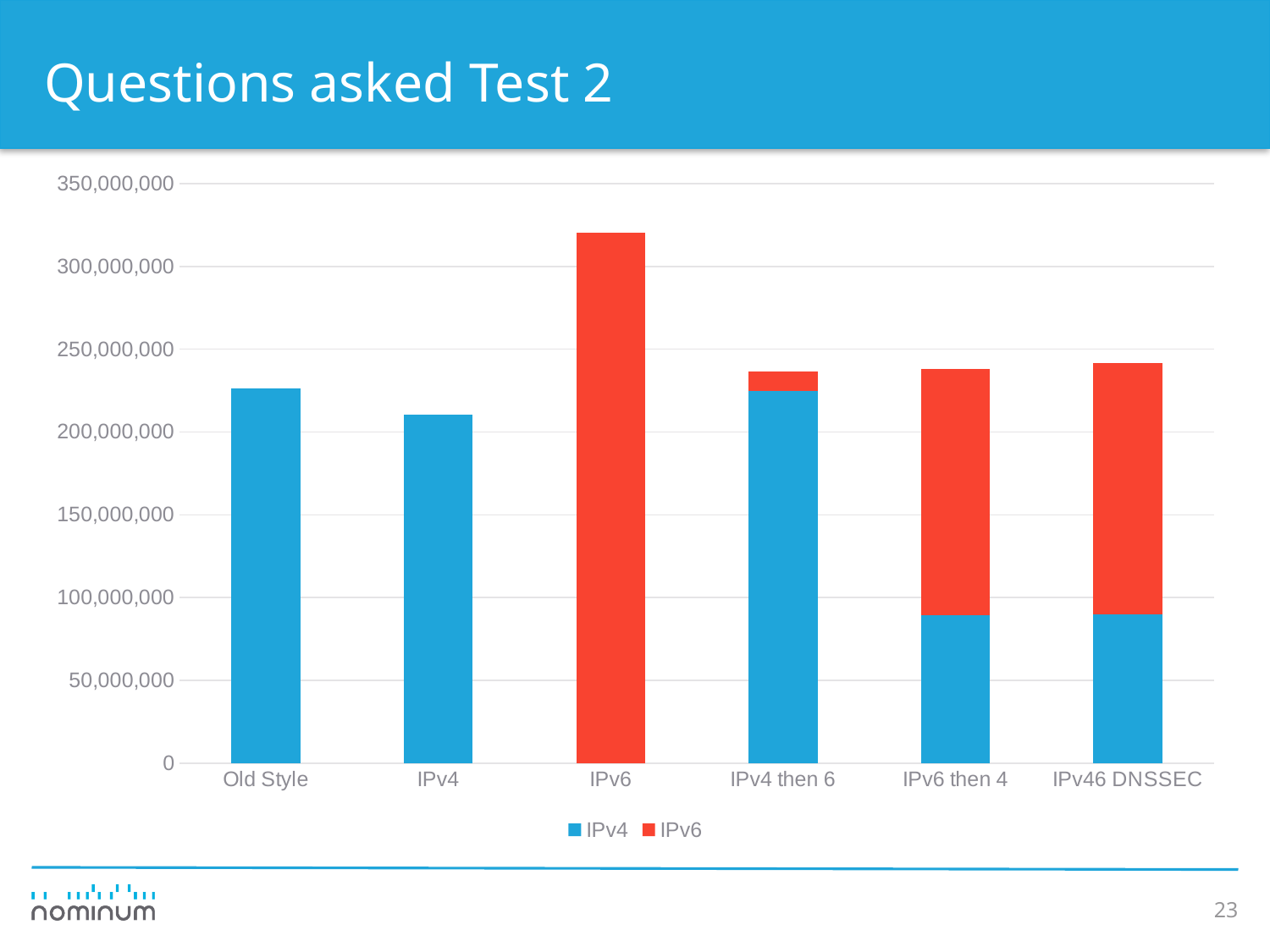
Is the IPv4 portion of the IPv6 then 4 bar greater or less than 100,000,000? less How many series does the chart's legend list? 2 What is the title of the slide containing the chart? Questions asked Test 2 Is the bar for Old Style greater or less than 250,000,000? less Which category has the shortest bar in the chart? IPv4 Is the total bar for IPv6 greater or less than 300,000,000? greater Which category has the tallest bar in the chart? IPv6 How many categories are shown on the x axis of the chart? 6 What colour represents the IPv6 series in the chart? red What kind of chart is shown on the slide? bar chart Which bar is taller, Old Style or IPv4? Old Style